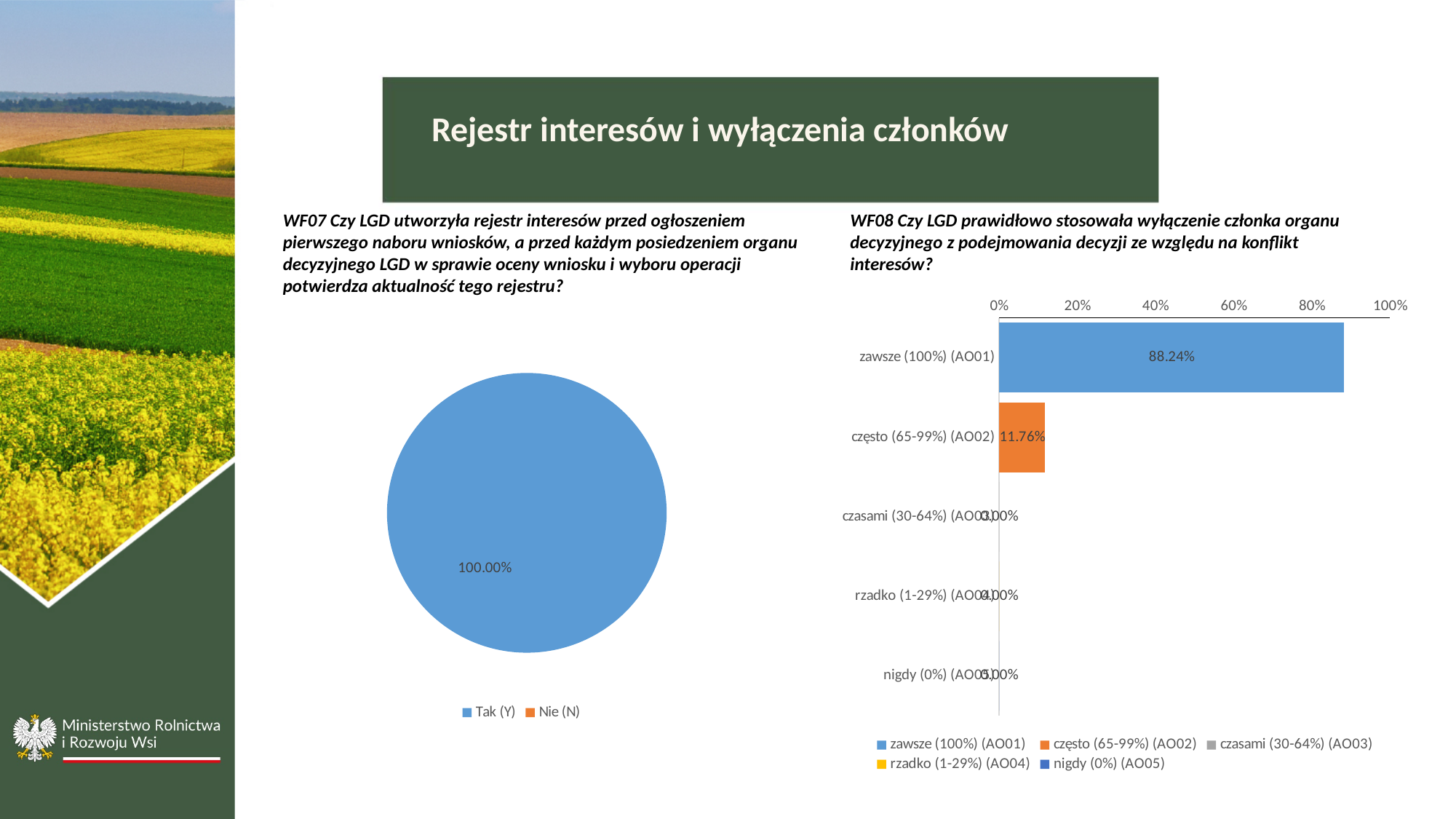
How many entries does the legend of the WF07 pie chart list? 2 In the WF08 bar chart, what is the difference between the values for zawsze (100%) (AO01) and często (65-99%) (AO02)? 76.48% What kind of chart is the WF07 chart on the left? pie chart In the WF08 bar chart, which is larger: the value for często (65-99%) (AO02) or the value for nigdy (0%) (AO05)? często (65-99%) (AO02) What kind of chart is the WF08 chart on the right? bar chart How many categories are shown in the WF08 bar chart? 5 In the WF07 pie chart on the left, what share is shown for Tak (Y)? 100.00% In the WF08 bar chart, which category has the highest value? zawsze (100%) (AO01) In the WF08 bar chart, what is the value for czasami (30-64%) (AO03)? 0.00% In the WF08 bar chart, what is the value for zawsze (100%) (AO01)? 88.24% In the WF08 bar chart, what is the value for często (65-99%) (AO02)? 11.76% In the WF08 bar chart, is the value for zawsze (100%) (AO01) greater or less than 80%? greater